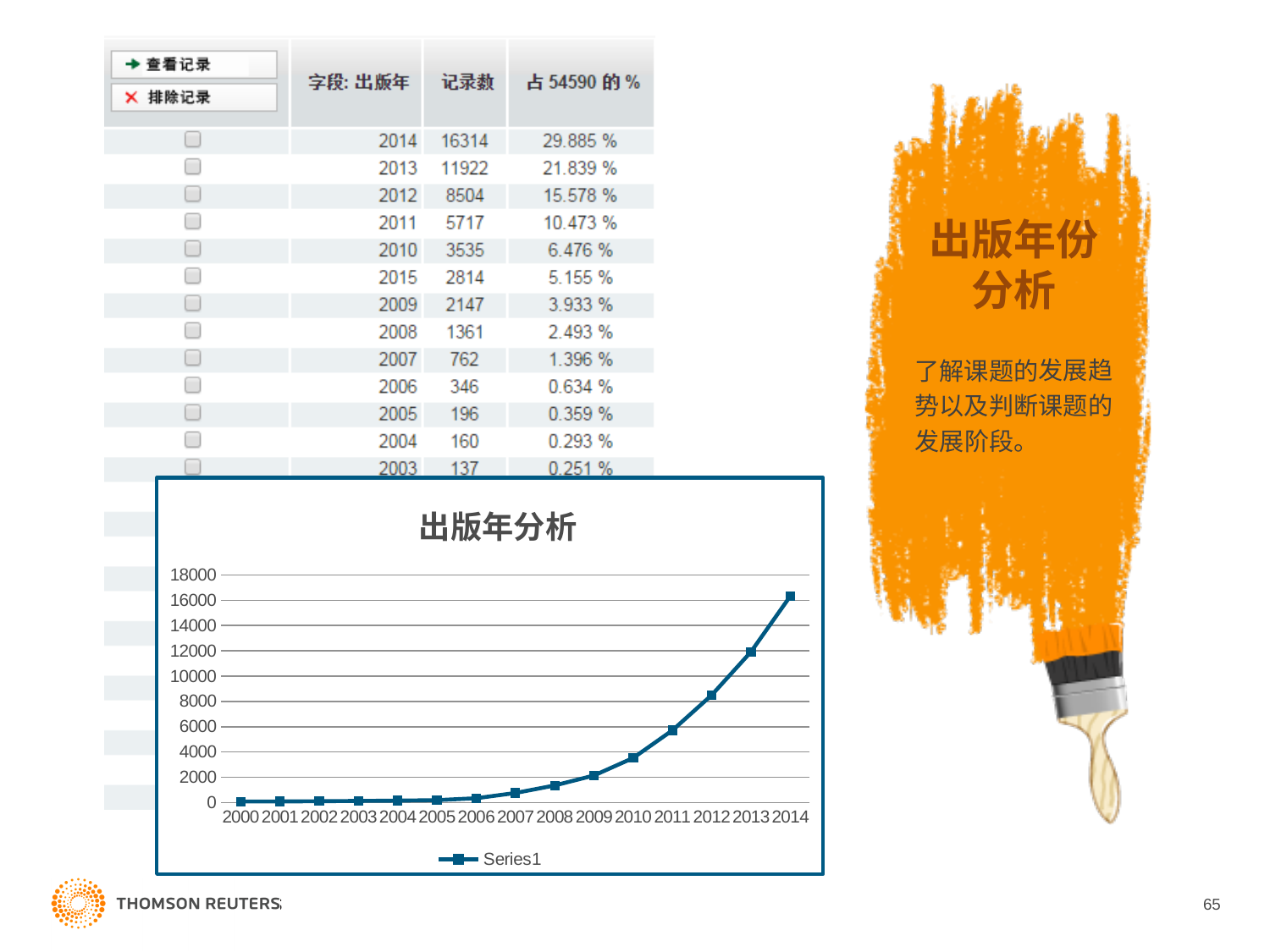
Is the value for 2010 greater or less than 4000? less How many series does the chart legend list? 1 Which year has the larger value in the chart, 2011 or 2009? 2011 Is the value for 2013 greater or less than 10000? greater What is the title of the chart? 出版年分析 Do the values in the chart rise or fall from 2000 to 2014? rise Which year has the highest value in the chart? 2014 How many years are plotted along the x axis of the chart? 15 Is the value for 2014 greater or less than 14000? greater What is the name of the series shown in the chart legend? Series1 What kind of chart is shown on the slide? line chart